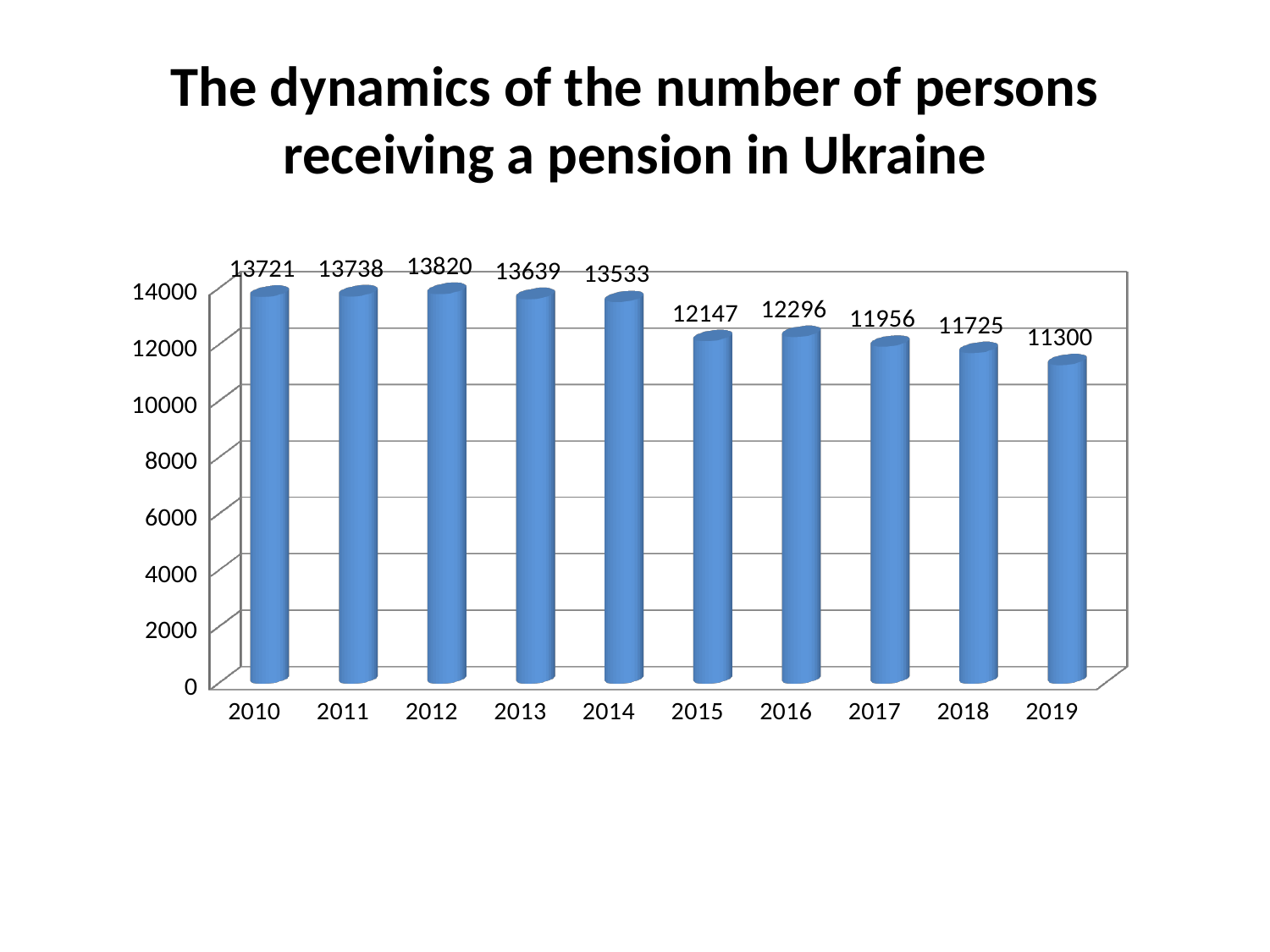
How many years are shown on the x axis? 10 Which year has the highest value? 2012 Do the values generally rise or fall from 2014 to 2019? fall Which year has the lowest value? 2019 Which is larger, the value for 2016 or the value for 2017? 2016 What kind of chart is this? bar chart What is the value for 2010? 13721 What is the difference between the values for 2010 and 2019? 2421 What is the difference between the values for 2014 and 2015? 1386 Is the value for 2018 greater or less than 12000? less What is the value for 2015? 12147 What is the value for 2019? 11300